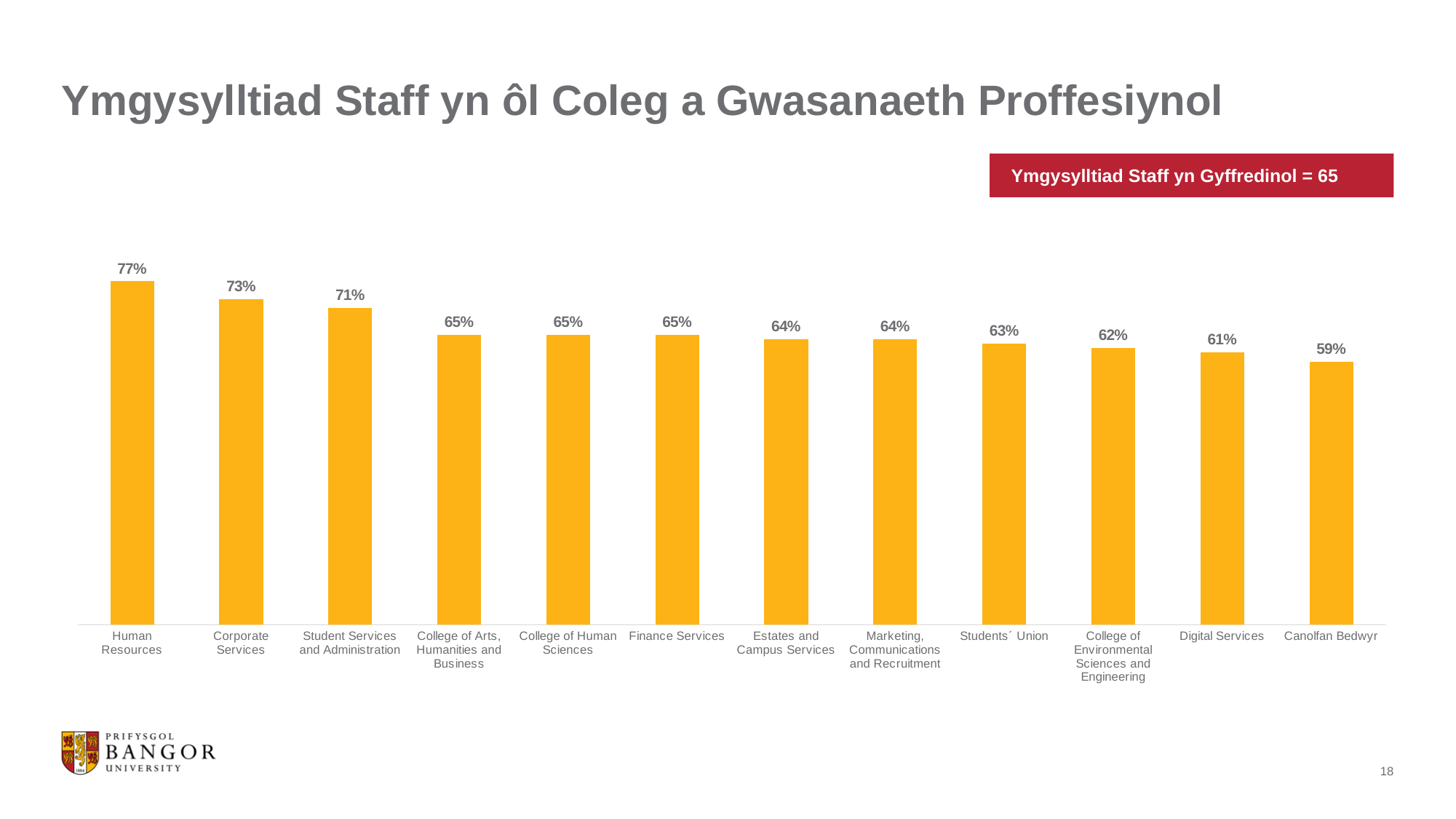
What is the value for Student Services and Administration? 71% What is the difference between the values for Human Resources and Corporate Services? 4% What kind of chart is shown on the slide? Bar chart Which is larger, the value for Corporate Services or the value for Students' Union? Corporate Services Which category has the lowest value? Canolfan Bedwyr What is the value for Digital Services? 61% Which category has the highest value? Human Resources What is the value for Canolfan Bedwyr? 59% How many categories are shown in the chart? 12 Do the values rise or fall from left to right along the x axis? Fall What is the value for Human Resources? 77% What is the difference between the values for Student Services and Administration and Canolfan Bedwyr? 12%